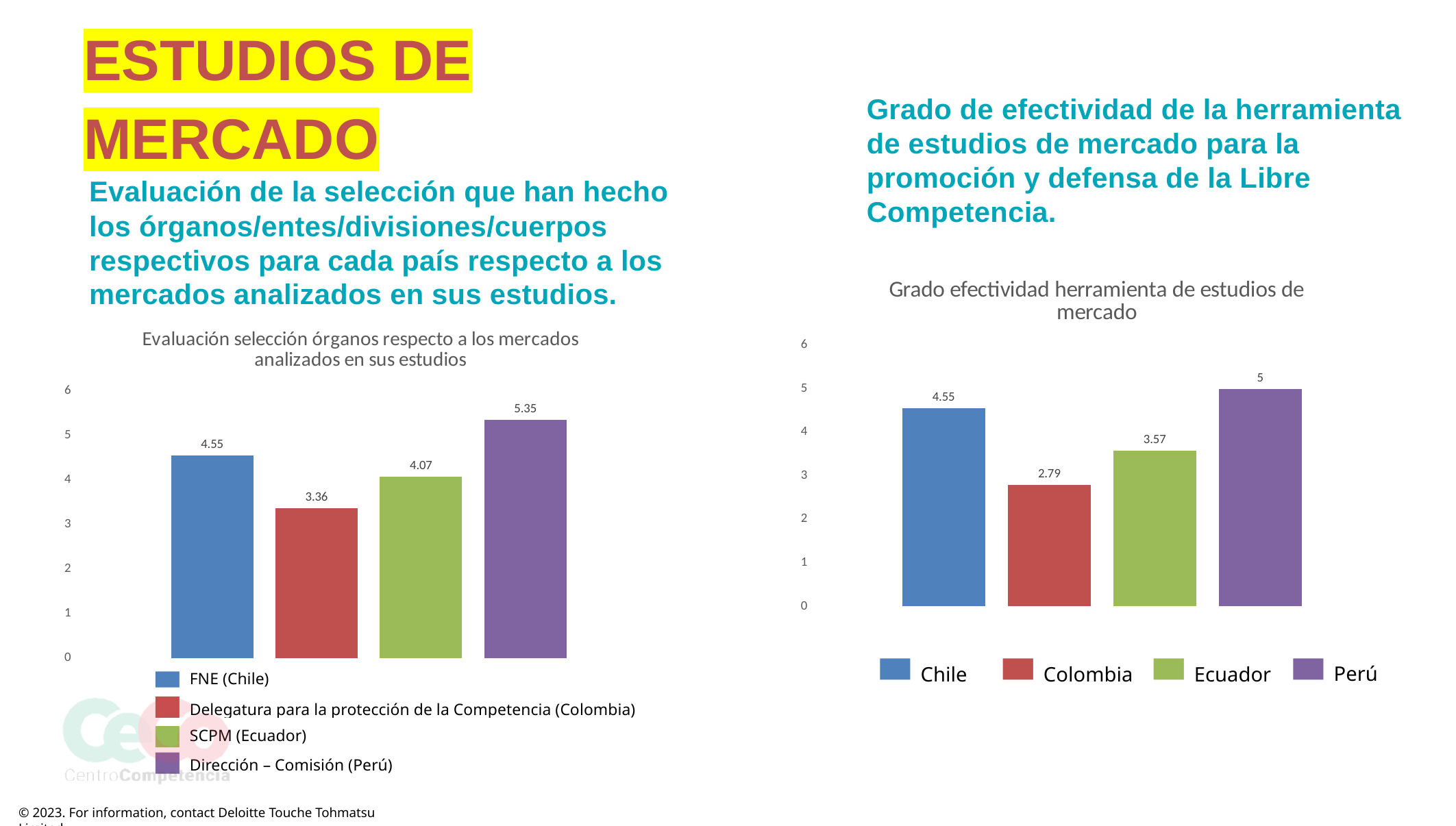
In the right chart 'Grado efectividad herramienta de estudios de mercado', which is larger, the value for Chile or the value for Ecuador? Chile In the right chart 'Grado efectividad herramienta de estudios de mercado', what is the value for Colombia? 2.79 In the right chart 'Grado efectividad herramienta de estudios de mercado', what is the difference between the values for Chile and Colombia? 1.76 In the right chart 'Grado efectividad herramienta de estudios de mercado', which country has the highest value? Perú In the right chart 'Grado efectividad herramienta de estudios de mercado', how many entries does the legend list? 4 In the left chart 'Evaluación selección órganos respecto a los mercados analizados en sus estudios', how many bars are plotted? 4 In the left chart 'Evaluación selección órganos respecto a los mercados analizados en sus estudios', which entity has the highest value? Dirección – Comisión (Perú) In the left chart 'Evaluación selección órganos respecto a los mercados analizados en sus estudios', what is the difference between the values for Dirección – Comisión (Perú) and SCPM (Ecuador)? 1.28 In the left chart 'Evaluación selección órganos respecto a los mercados analizados en sus estudios', what kind of chart is it? Bar chart In the left chart 'Evaluación selección órganos respecto a los mercados analizados en sus estudios', what is the value for FNE (Chile)? 4.55 In the left chart 'Evaluación selección órganos respecto a los mercados analizados en sus estudios', which entity has the lowest value? Delegatura para la protección de la Competencia (Colombia) In the right chart 'Grado efectividad herramienta de estudios de mercado', what is the value for Perú? 5